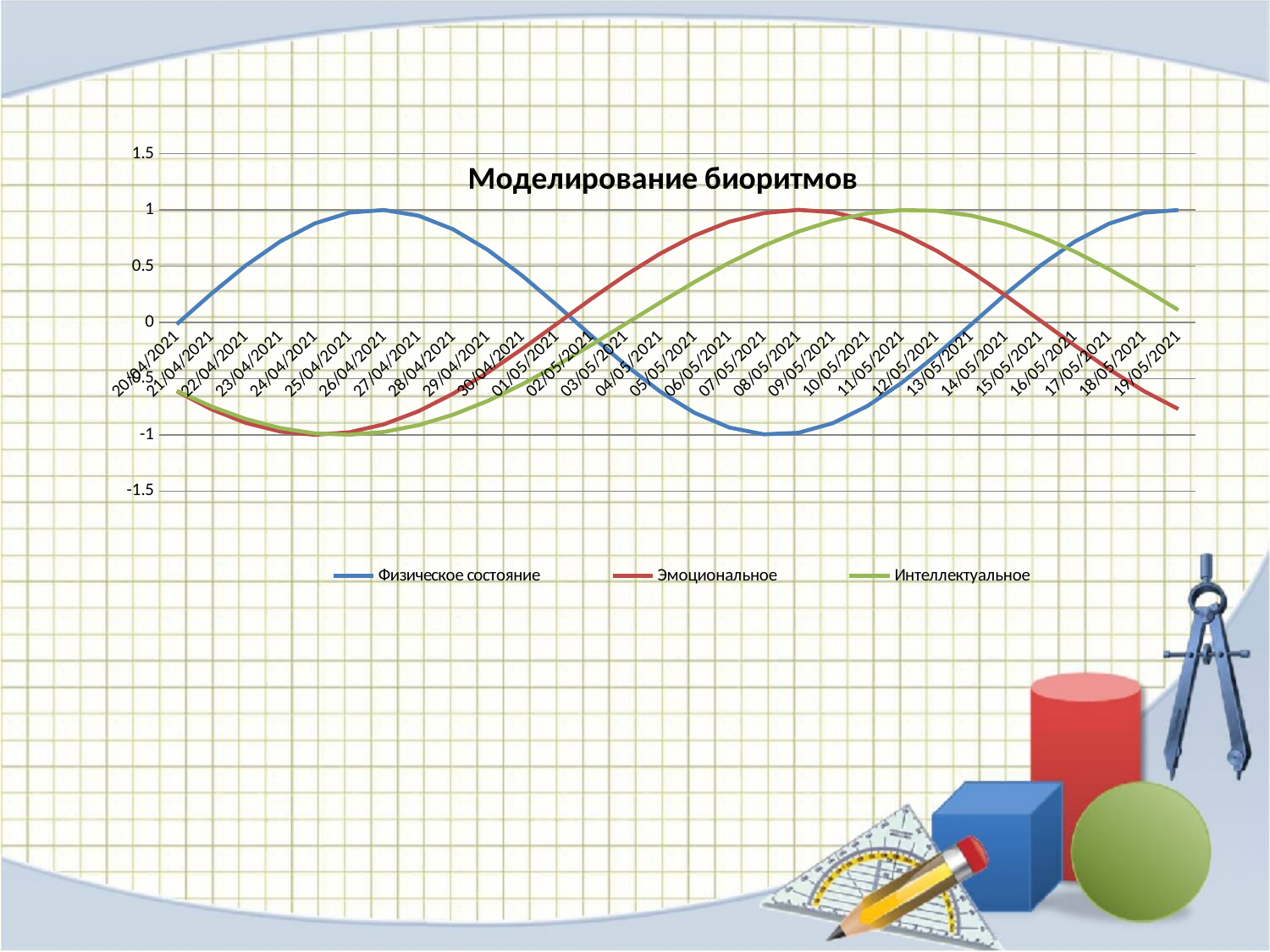
What is the title of the chart? Моделирование биоритмов How many dates are shown along the x axis? 30 Does the Физическое состояние line rise or fall from 20/04/2021 to 26/04/2021? rise On 08/05/2021, which series has the larger value, Эмоциональное or Физическое состояние? Эмоциональное Is the value for Физическое состояние on 07/05/2021 greater or less than 0? less What kind of chart is shown on the slide? line chart How many series does the legend list? 3 Is the value for Эмоциональное on 19/05/2021 greater or less than -0.5? less Is the value for Интеллектуальное on 25/04/2021 greater or less than -0.5? less Which series is drawn in red? Эмоциональное